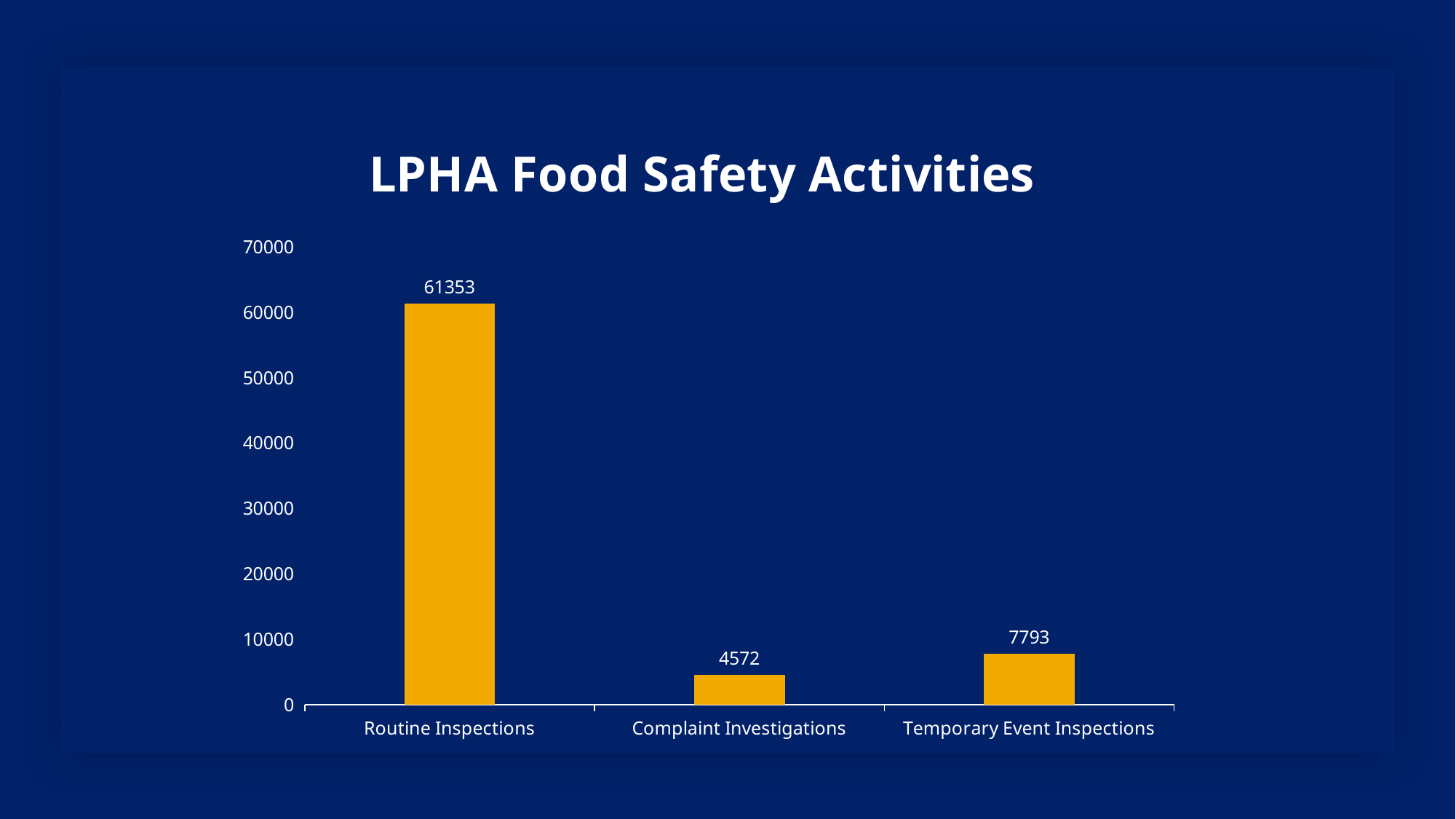
What kind of chart is shown on the slide? Bar chart Which category has the highest value? Routine Inspections Which category has the lowest value? Complaint Investigations What is the value for Complaint Investigations? 4572 How many categories are shown on the chart? 3 What is the value for Temporary Event Inspections? 7793 Which is larger, Complaint Investigations or Temporary Event Inspections? Temporary Event Inspections What is the value for Routine Inspections? 61353 What is the difference between Temporary Event Inspections and Complaint Investigations? 3221 Is the value for Routine Inspections greater or less than 60000? greater What is the title of the chart? LPHA Food Safety Activities What is the difference between Routine Inspections and Temporary Event Inspections? 53560